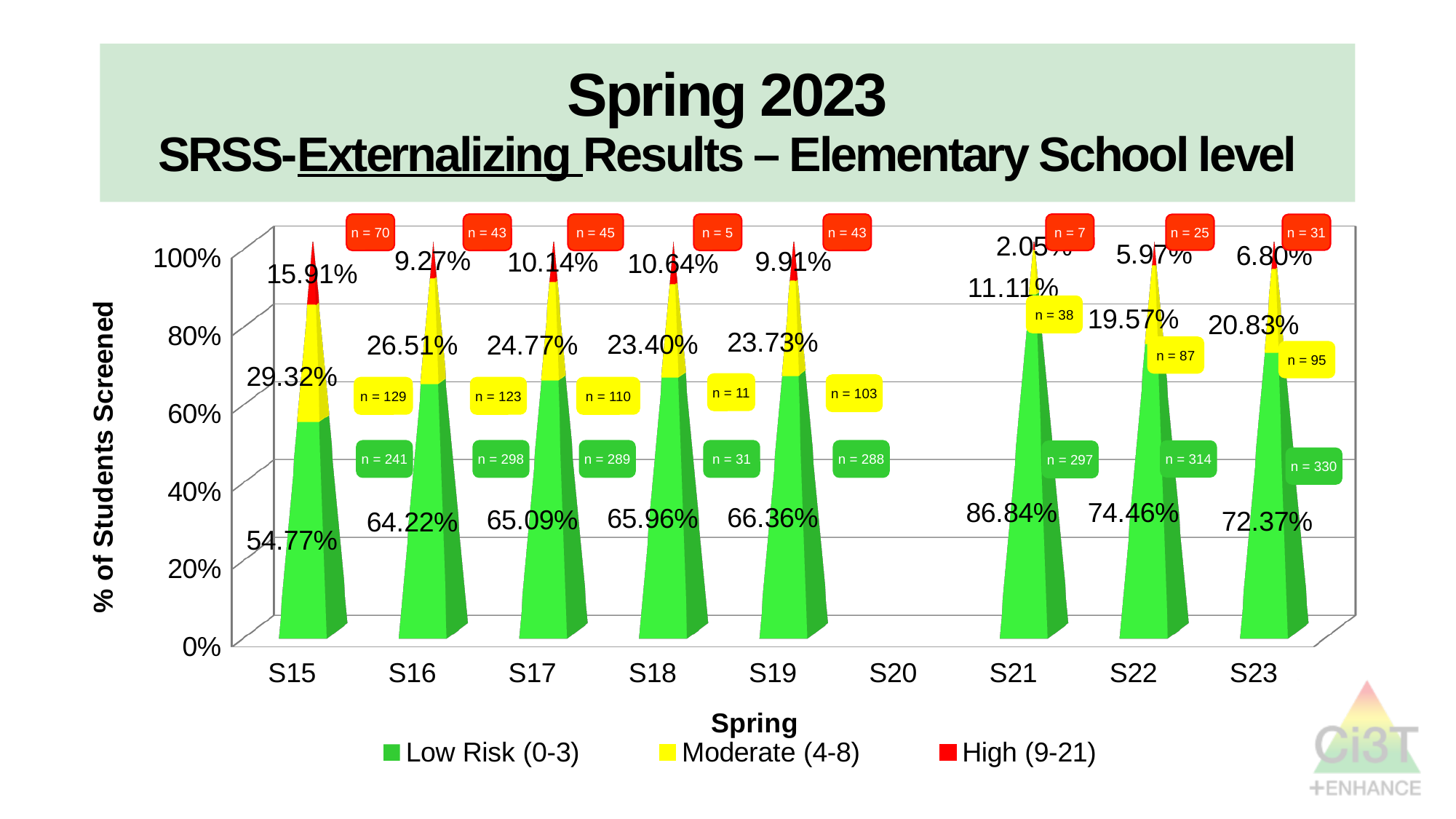
How many students were in the Low Risk (0-3) group in S22 (the n value)? n = 314 What percentage of students screened were High (9-21) in S15? 15.91% Which is larger, the Low Risk (0-3) percentage in S22 or in S23? S22 Which spring has the highest Low Risk (0-3) percentage? S21 What kind of chart is shown on the slide? Stacked bar chart Which spring has the lowest High (9-21) percentage? S21 How many spring categories are labeled on the x axis? 9 What percentage of students screened were Low Risk (0-3) in S21? 86.84% What percentage of students screened were Moderate (4-8) in S23? 20.83% How many series does the legend list? 3 Which spring has the lowest Low Risk (0-3) percentage? S15 What is the difference in percentage points between the High (9-21) share in S15 and in S16? 6.64 percentage points